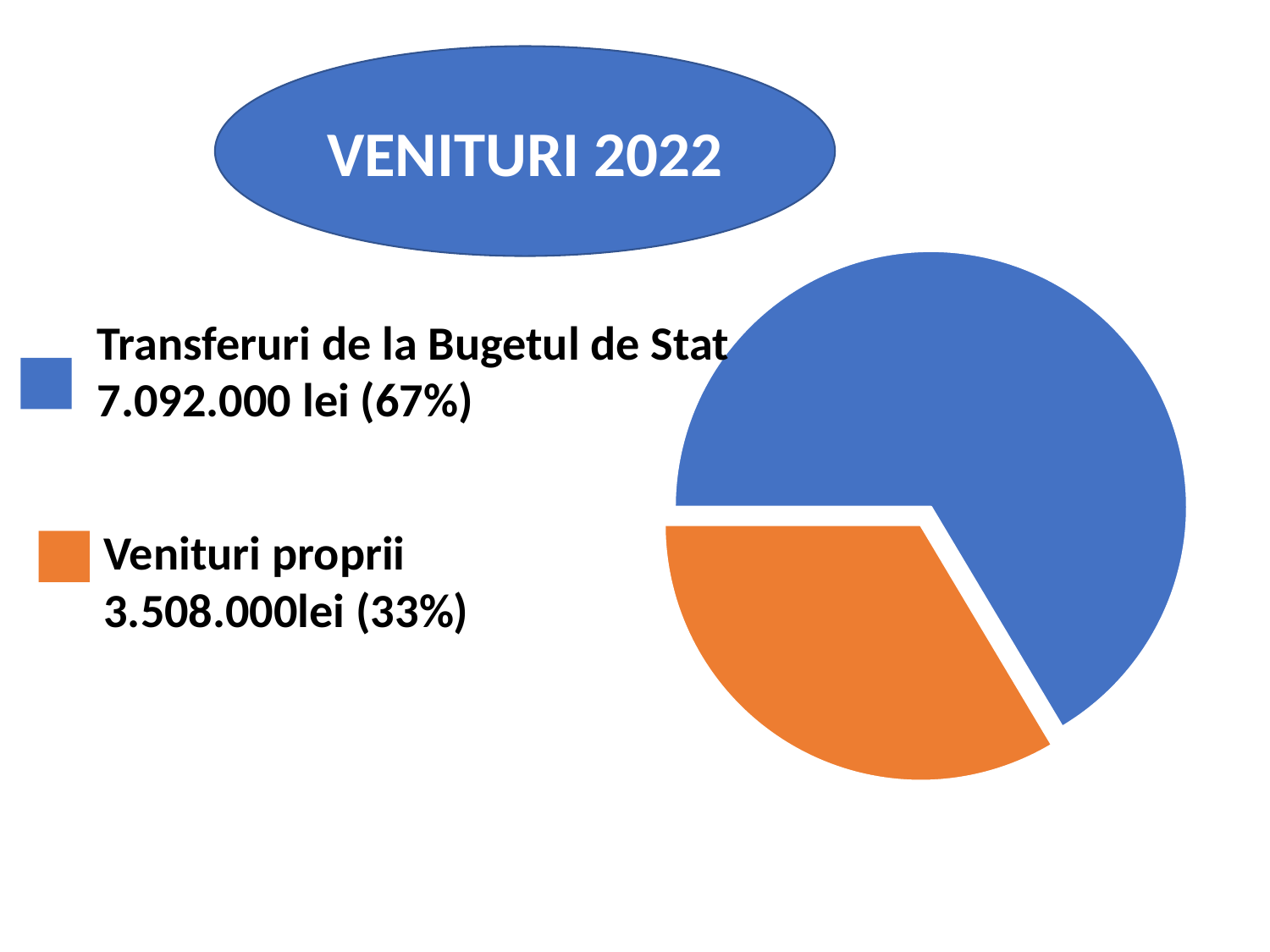
What is the value for Transferuri de la Bugetul de Stat? 7.092.000 lei Which is larger: Transferuri de la Bugetul de Stat or Venituri proprii? Transferuri de la Bugetul de Stat Which category has the largest slice of the pie? Transferuri de la Bugetul de Stat What share of the pie does Venituri proprii represent? 33% What share of the pie does Transferuri de la Bugetul de Stat represent? 67% What is the total of the two slices in the pie chart? 10.600.000 lei What is the title shown above the chart? VENITURI 2022 What type of chart is shown on the slide? pie chart Which category has the smallest slice of the pie? Venituri proprii What is the difference between Transferuri de la Bugetul de Stat and Venituri proprii? 3.584.000 lei How many slices does the pie chart have? 2 What is the value for Venituri proprii? 3.508.000 lei